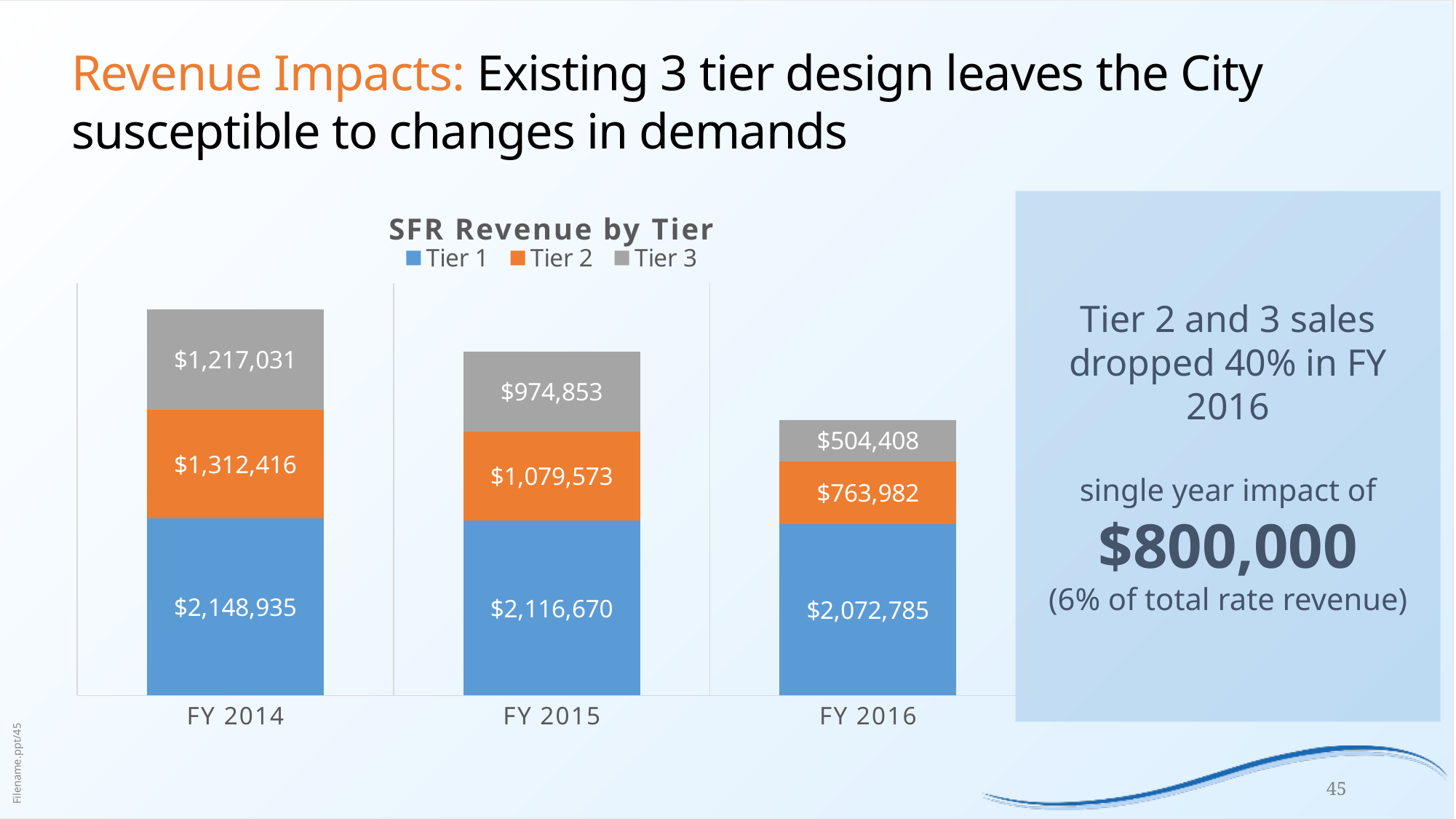
What is the Tier 2 revenue for FY 2015? $1,079,573 What type of chart is shown on the slide? Stacked bar chart What is the Tier 3 revenue for FY 2016? $504,408 What is the difference between Tier 3 revenue in FY 2014 and FY 2016? $712,623 How many fiscal years are shown on the x axis of the chart? 3 What is the total SFR revenue across all tiers for FY 2016? $3,341,175 What is the title of the chart? SFR Revenue by Tier How many series does the chart legend list? 3 What is the Tier 1 revenue for FY 2014? $2,148,935 Which fiscal year has the highest Tier 3 revenue? FY 2014 Does total SFR revenue rise or fall from FY 2014 to FY 2016? Fall Which fiscal year has the lowest Tier 2 revenue? FY 2016